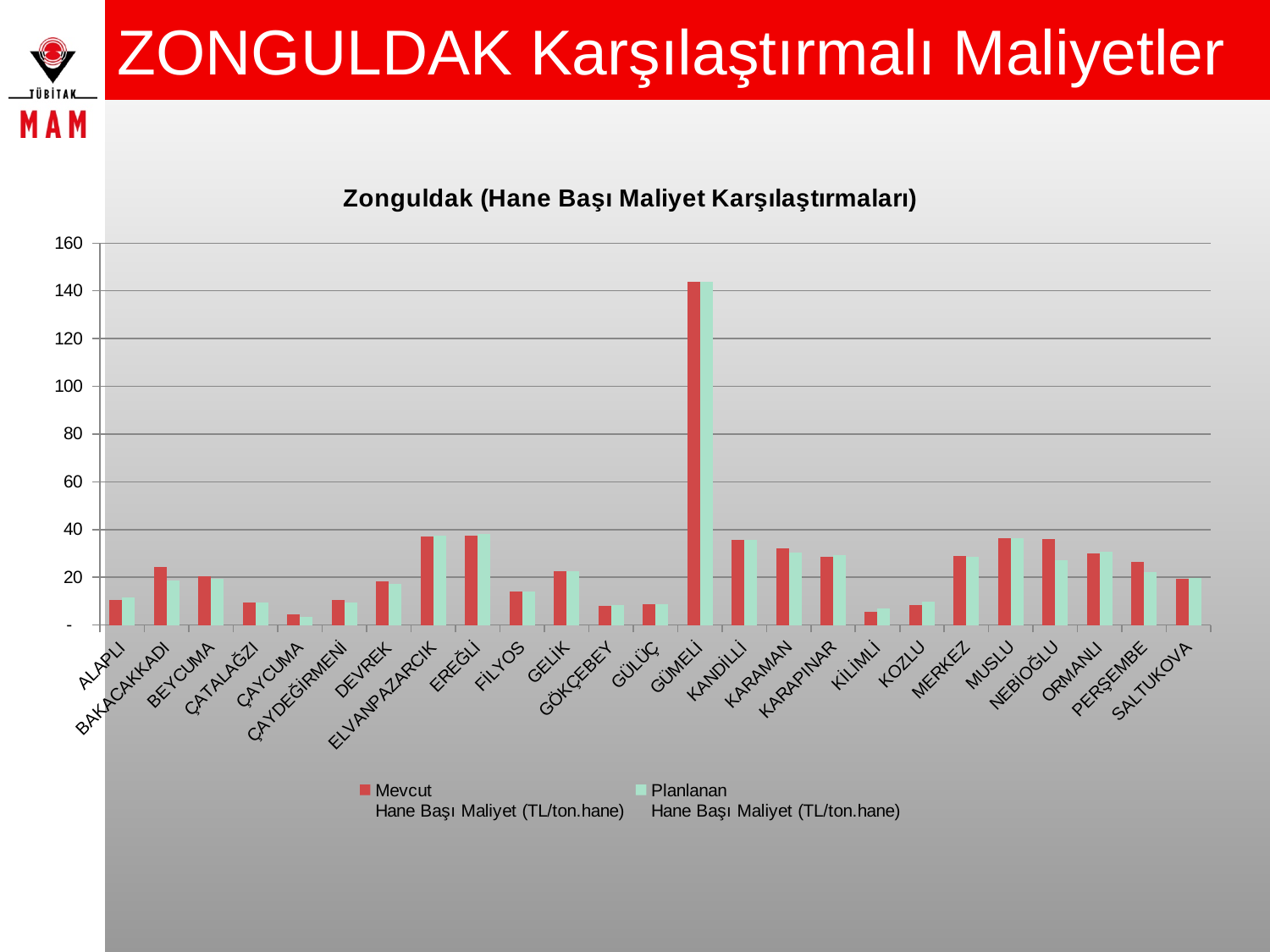
Is the Mevcut Hane Başı Maliyet value for GÜMELİ greater or less than 120? greater Is the Mevcut Hane Başı Maliyet value for ALAPLI greater or less than 20? less Which category has the lowest Planlanan Hane Başı Maliyet value? ÇAYCUMA How many categories are shown on the x axis? 25 What is the title of the chart? Zonguldak (Hane Başı Maliyet Karşılaştırmaları) Is the Planlanan Hane Başı Maliyet value for MUSLU greater or less than 40? less Which category has the highest Mevcut Hane Başı Maliyet value? GÜMELİ How many series does the legend list? 2 For NEBİOĞLU, which is larger: the Mevcut or the Planlanan Hane Başı Maliyet value? Mevcut What kind of chart is shown on the slide? bar chart Which has the larger Mevcut Hane Başı Maliyet value: ELVANPAZARCIK or DEVREK? ELVANPAZARCIK